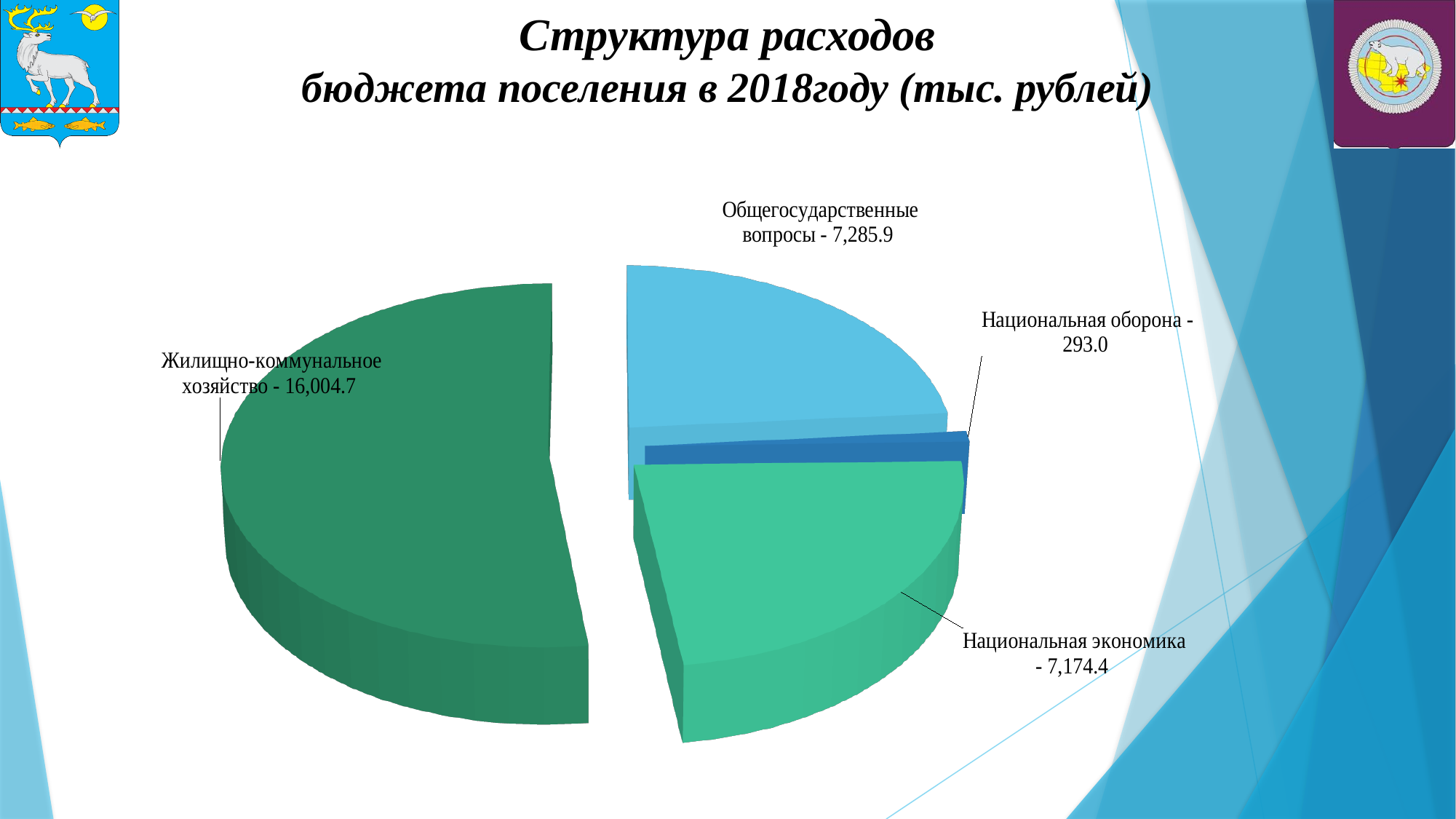
Which category has the largest share of the pie? Жилищно-коммунальное хозяйство What is the value for Национальная оборона? 293.0 What is the value for Национальная экономика? 7,174.4 What is the value for Жилищно-коммунальное хозяйство? 16,004.7 Which category has the smallest share of the pie? Национальная оборона What is the total of all slices in the pie chart? 30,758.0 What is the title of the chart on the slide? Структура расходов бюджета поселения в 2018году (тыс. рублей) What is the value for Общегосударственные вопросы? 7,285.9 How many slices does the pie chart have? 4 What is the difference between Жилищно-коммунальное хозяйство and Общегосударственные вопросы? 8,718.8 What type of chart is shown on the slide? pie chart Which is larger: Общегосударственные вопросы or Национальная экономика? Общегосударственные вопросы